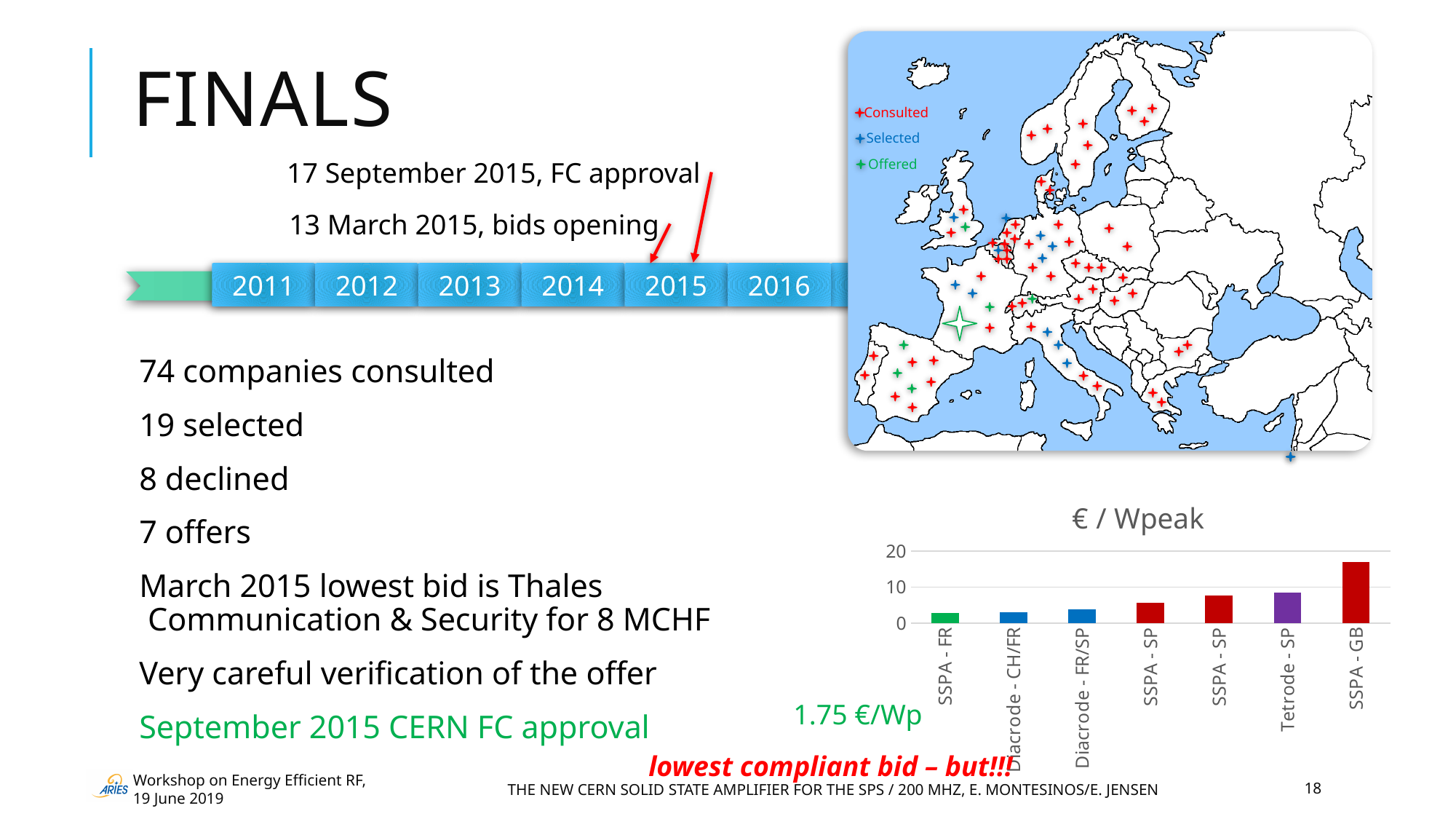
In the "€ / Wpeak" chart, what colour is the bar for Tetrode - SP? purple In the "€ / Wpeak" chart, is the value for Tetrode - SP greater or less than 10? less In the "€ / Wpeak" chart, which is larger: SSPA - GB or Tetrode - SP? SSPA - GB How many bars are plotted in the "€ / Wpeak" chart? 7 What is the title of the bar chart on the slide? € / Wpeak In the "€ / Wpeak" chart, which is larger: Tetrode - SP or SSPA - FR? Tetrode - SP What kind of chart is the "€ / Wpeak" chart? bar chart In the "€ / Wpeak" chart, which category has the highest value? SSPA - GB In the "€ / Wpeak" chart, is the value for Diacrode - FR/SP greater or less than 10? less In the "€ / Wpeak" chart, do the bar values generally rise or fall from left to right? rise In the "€ / Wpeak" chart, is the value for SSPA - GB greater or less than 10? greater In the "€ / Wpeak" chart, which is larger: Diacrode - CH/FR or SSPA - GB? SSPA - GB